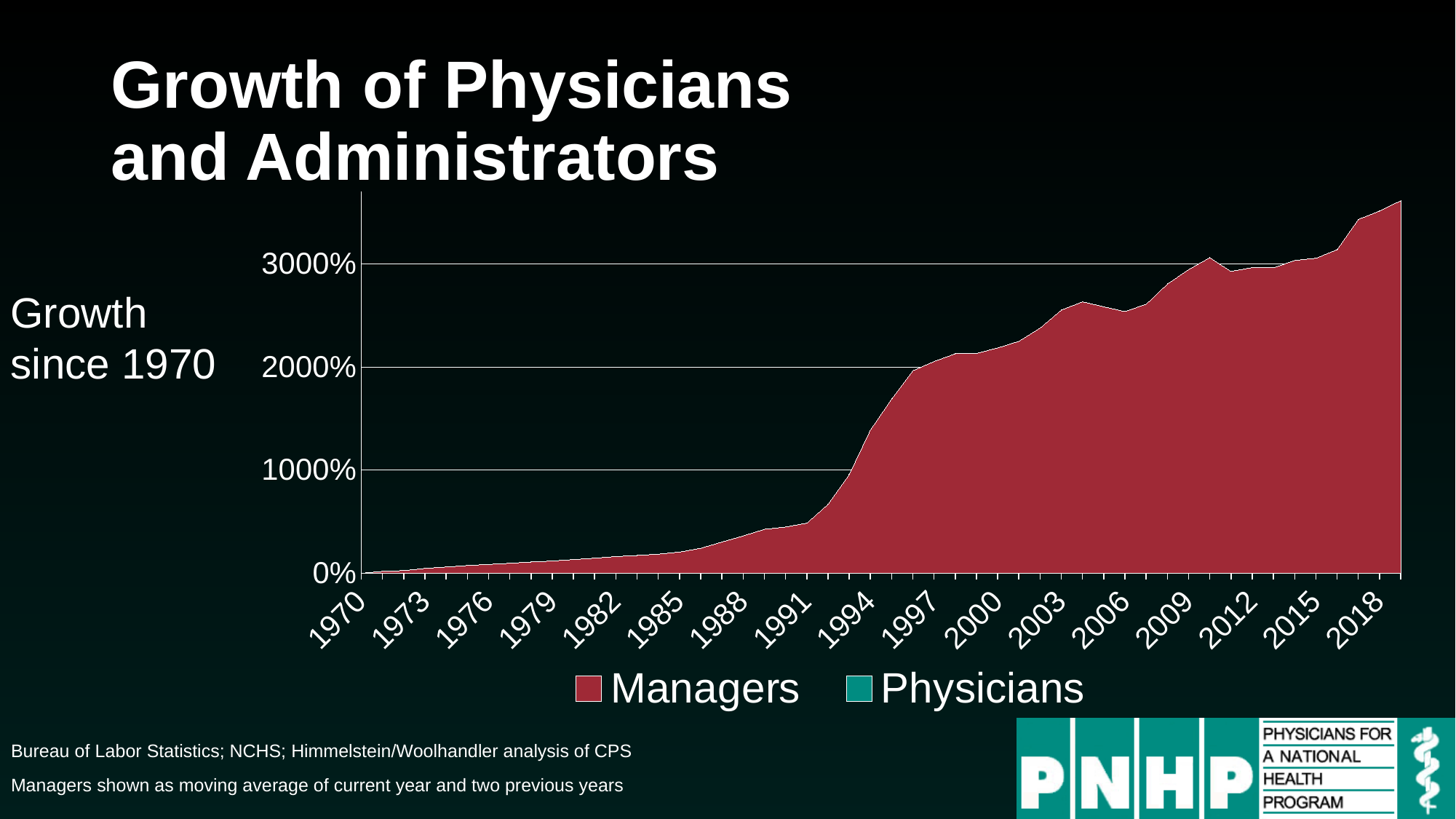
Is the value for Managers in 2003 greater or less than 2000%? greater Which is larger, the Managers value in 2003 or in 1991? 2003 What kind of chart is shown on the slide? Area chart What is the title of the chart on the slide? Growth of Physicians and Administrators Does the Managers series generally rise or fall from 1970 to 2018? Rise Is the value for Managers in 2018 greater or less than 3000%? greater Is the value for Managers in 2006 greater or less than 3000%? less How many series does the legend list? 2 How many year labels are shown on the x axis? 17 What are the two series named in the legend? Managers and Physicians Which series shows higher growth since 1970, Managers or Physicians? Managers